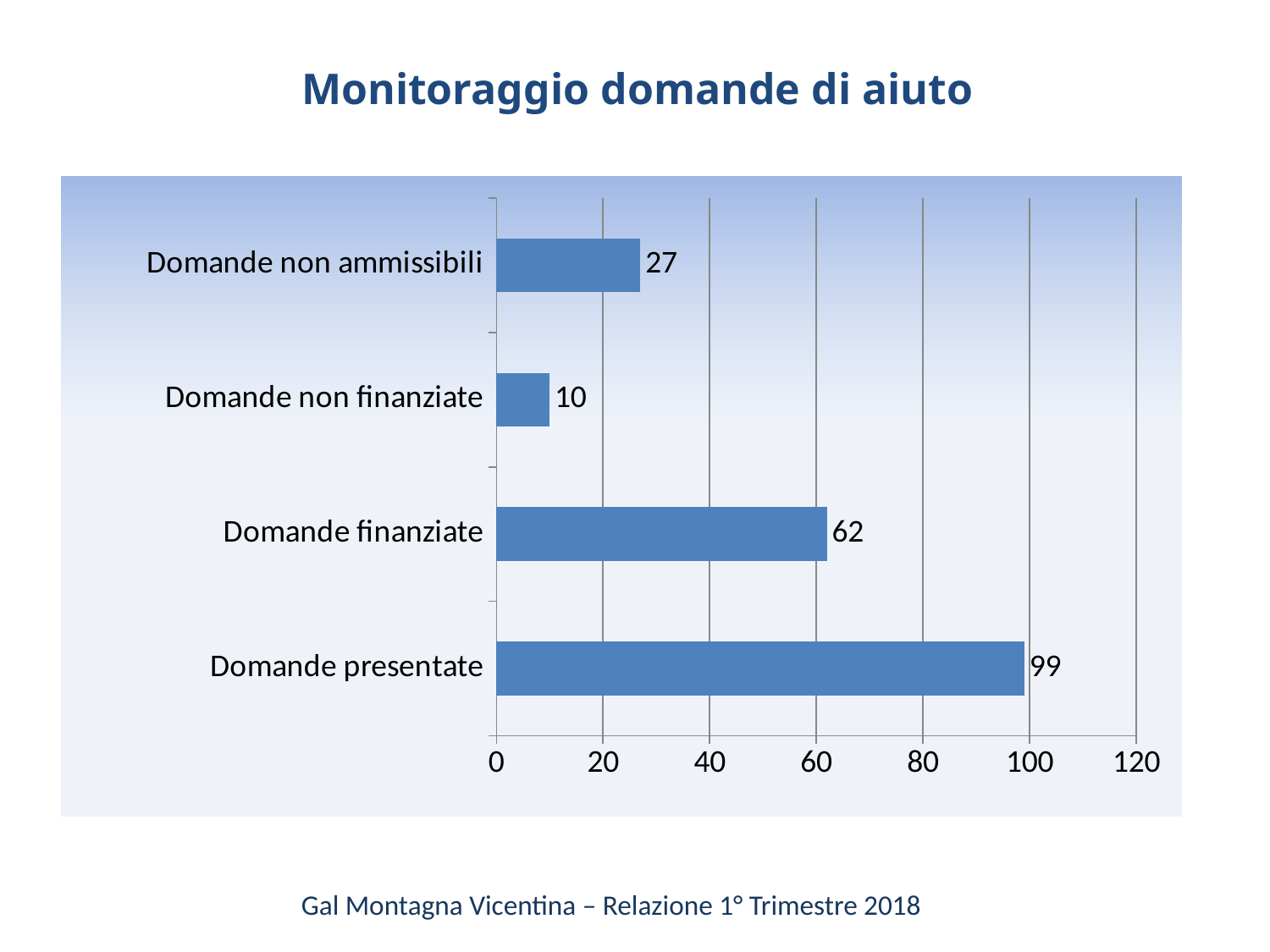
What is the value for Domande non ammissibili? 27 What kind of chart is shown on the slide? Bar chart What is the value for Domande non finanziate? 10 What is the value for Domande finanziate? 62 What is the value for Domande presentate? 99 Which category has the lowest value? Domande non finanziate Which category has the highest value? Domande presentate What is the difference between Domande presentate and Domande finanziate? 37 Which is larger, Domande non ammissibili or Domande non finanziate? Domande non ammissibili Is the value for Domande finanziate greater or less than 60? greater How many categories are shown in the chart? 4 What is the difference between Domande non ammissibili and Domande non finanziate? 17